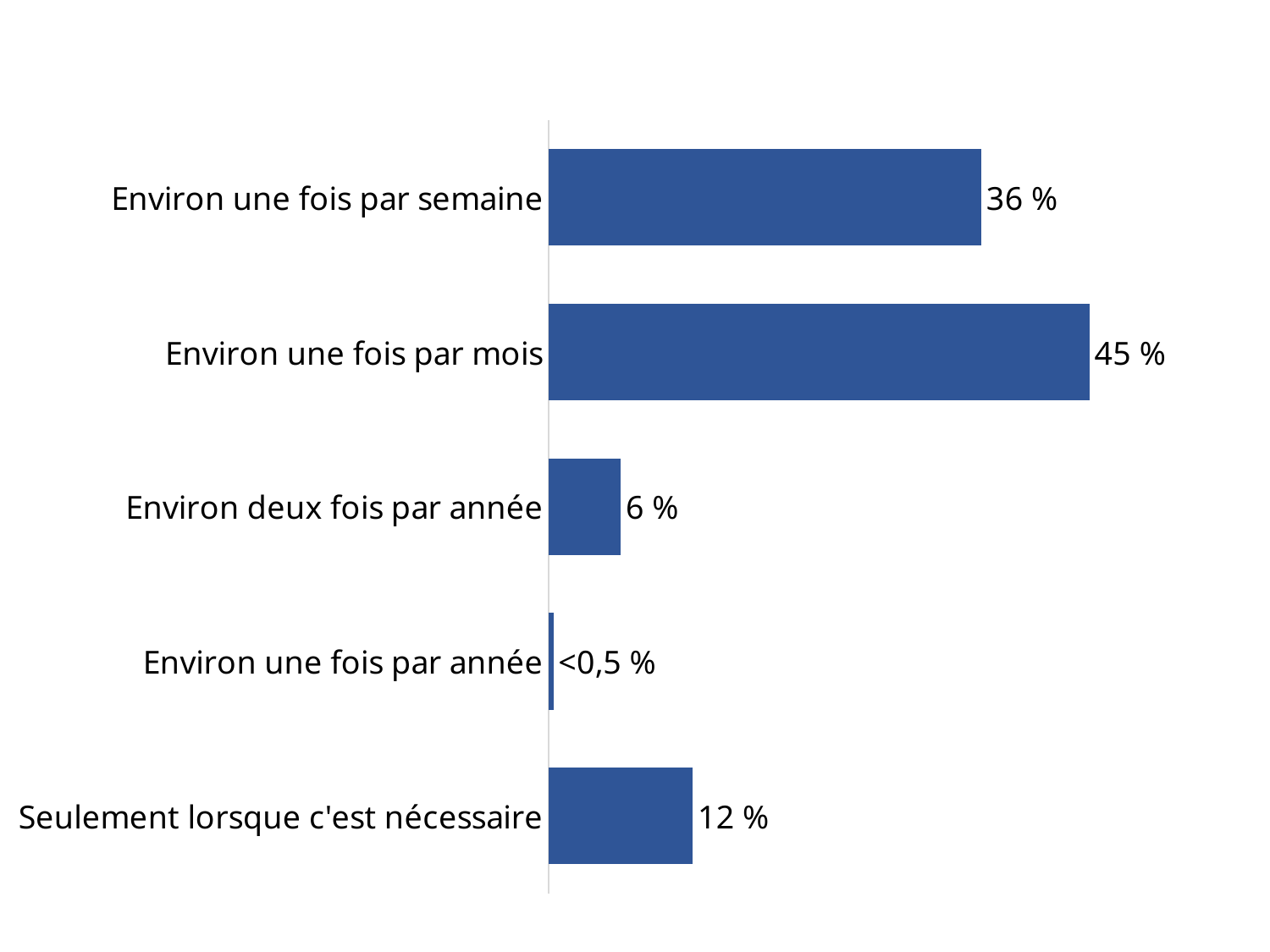
Which category has the lowest value? Environ une fois par année What kind of chart is shown on the slide? Bar chart What is the value for "Seulement lorsque c'est nécessaire"? 12 % What is the value for "Environ une fois par semaine"? 36 % How many categories are shown in the chart? 5 What is the value shown for "Environ une fois par année"? <0,5 % Which is larger: the value for "Environ une fois par semaine" or the value for "Seulement lorsque c'est nécessaire"? Environ une fois par semaine What is the difference between the values for "Environ une fois par mois" and "Environ une fois par semaine"? 9 % Which category has the highest value? Environ une fois par mois What is the value for "Environ deux fois par année"? 6 % What is the value for "Environ une fois par mois"? 45 % What is the difference between the values for "Seulement lorsque c'est nécessaire" and "Environ deux fois par année"? 6 %